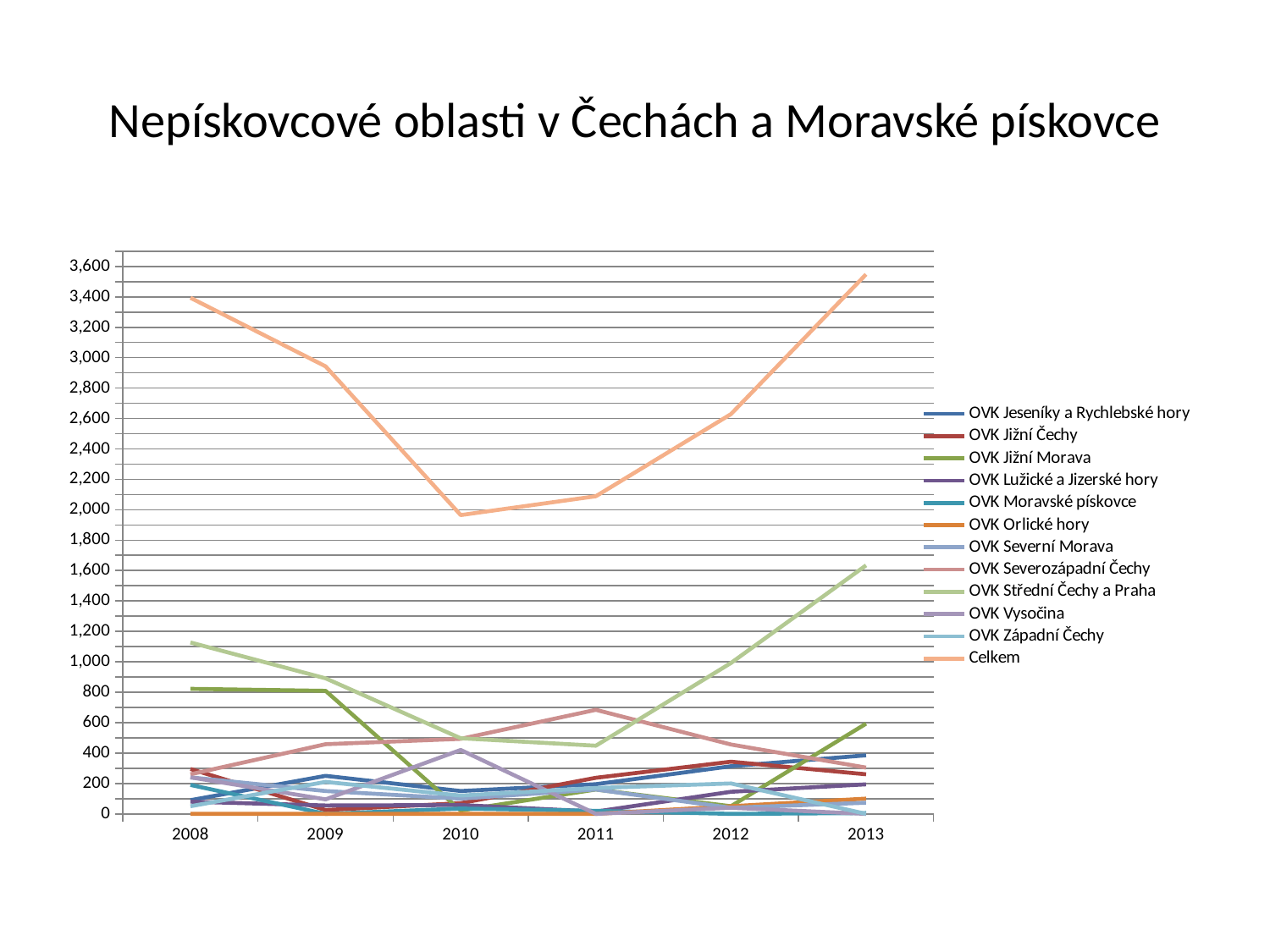
Which series has the highest value in 2013? Celkem Is the value for OVK Střední Čechy a Praha in 2013 greater or less than 1,400? greater What is the title of the slide? Nepískovcové oblasti v Čechách a Moravské pískovce Is the value for Celkem in 2010 greater or less than 2,200? less In which year is the Celkem series at its lowest? 2010 How many years are shown on the x axis? 6 Is the value for Celkem in 2008 greater or less than 3,000? greater In 2013, which is larger: OVK Střední Čechy a Praha or OVK Jižní Morava? OVK Střední Čechy a Praha How many series does the legend list? 12 What kind of chart is shown on the slide? line chart In which year is the Celkem series at its highest? 2013 Does the Celkem series rise or fall from 2010 to 2013? rises